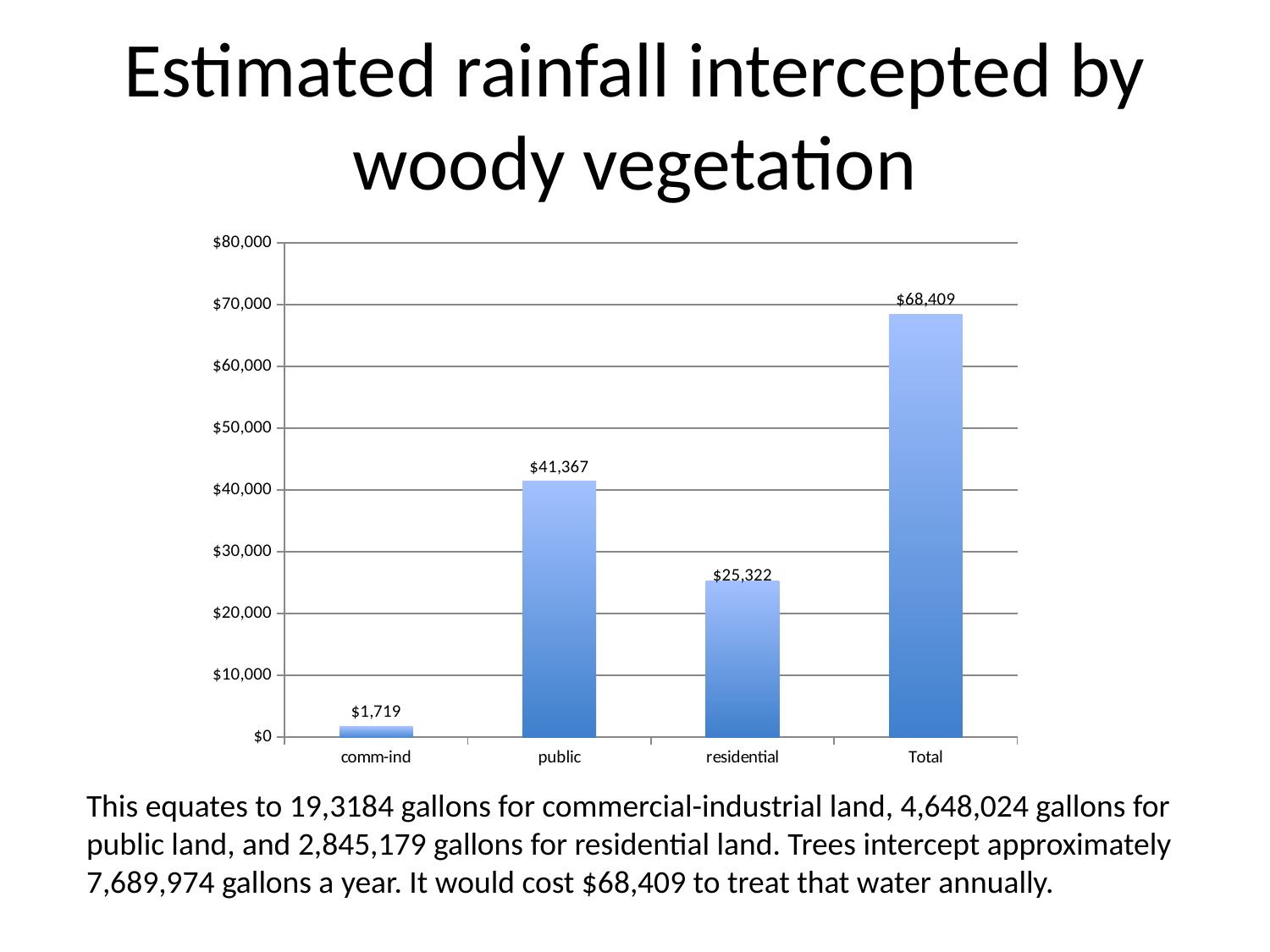
What is the value for Total? $68,409 Is the value for residential greater or less than $30,000? less What is the value for residential? $25,322 What is the title of the slide containing the chart? Estimated rainfall intercepted by woody vegetation Which is larger, the value for public or the value for residential? public Which category has the lowest value? comm-ind How many categories are shown on the x axis? 4 What kind of chart is shown on the slide? bar chart What is the value for comm-ind? $1,719 What is the value for public? $41,367 What is the difference between the values for public and residential? $16,045 Which category has the highest value? Total